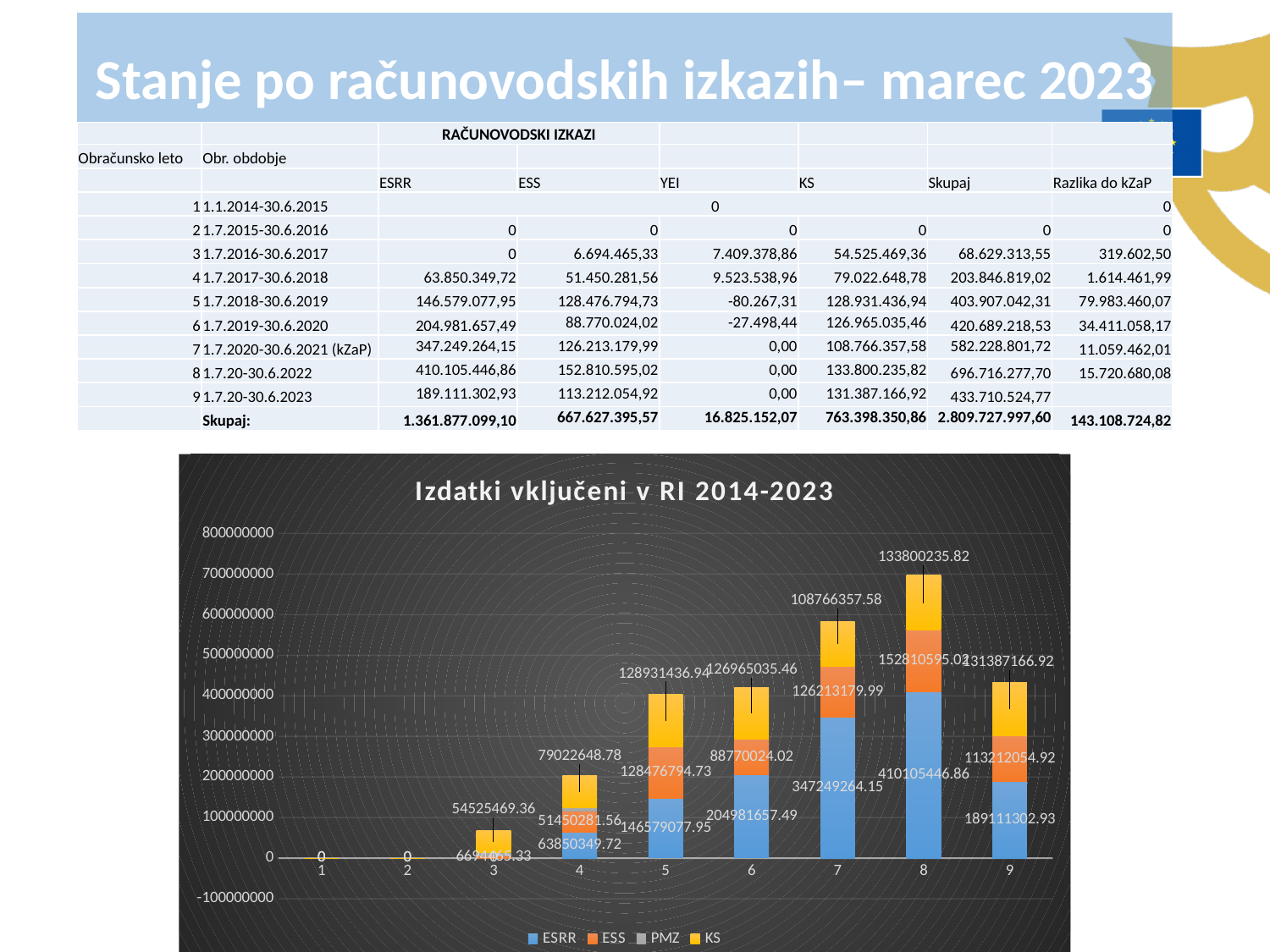
What is the title of the chart on the slide? Izdatki vključeni v RI 2014-2023 Is the total stacked bar for category 8 greater or less than 600000000? greater How many categories are shown on the x axis of the chart? 9 Which is larger in the chart: the ESRR value for category 8 or the ESRR value for category 9? category 8 Does the ESRR value rise or fall from category 8 to category 9 in the chart? fall What type of chart is shown on the slide? stacked bar chart How many series does the chart legend list? 4 What is the difference between the KS value for category 8 and the KS value for category 9 in the chart? 2413068.90 What is the ESRR value for category 7 in the chart? 347249264.15 What is the ESS value for category 9 in the chart? 113212054.92 Which category has the tallest stacked bar in the chart? 8 What is the KS value for category 8 in the chart? 133800235.82